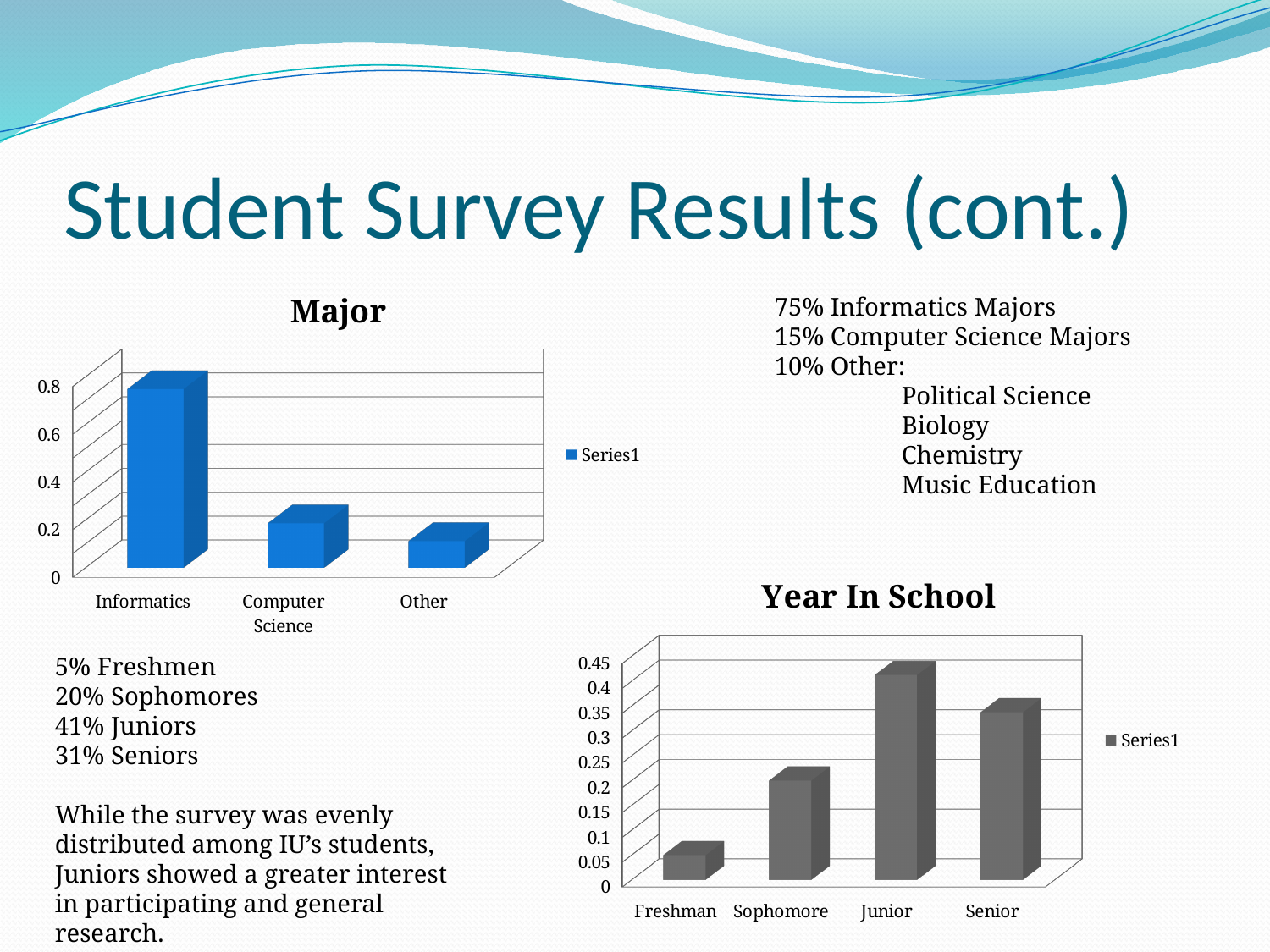
In the "Major" chart, which category has the lowest value? Other In the "Major" chart, is the value for Informatics greater or less than 0.6? greater In the "Year In School" chart, which category has the highest value? Junior In the "Year In School" chart, what is the value for Sophomore? 0.2 How many series does the legend of the "Year In School" chart list? 1 In the "Major" chart, which category has the highest value? Informatics How many categories are shown in the "Major" chart? 3 What kind of chart is the "Major" chart? bar chart In the "Year In School" chart, which category has the lowest value? Freshman In the "Year In School" chart, which is larger, the value for Junior or the value for Senior? Junior In the "Year In School" chart, is the value for Senior greater or less than 0.3? greater